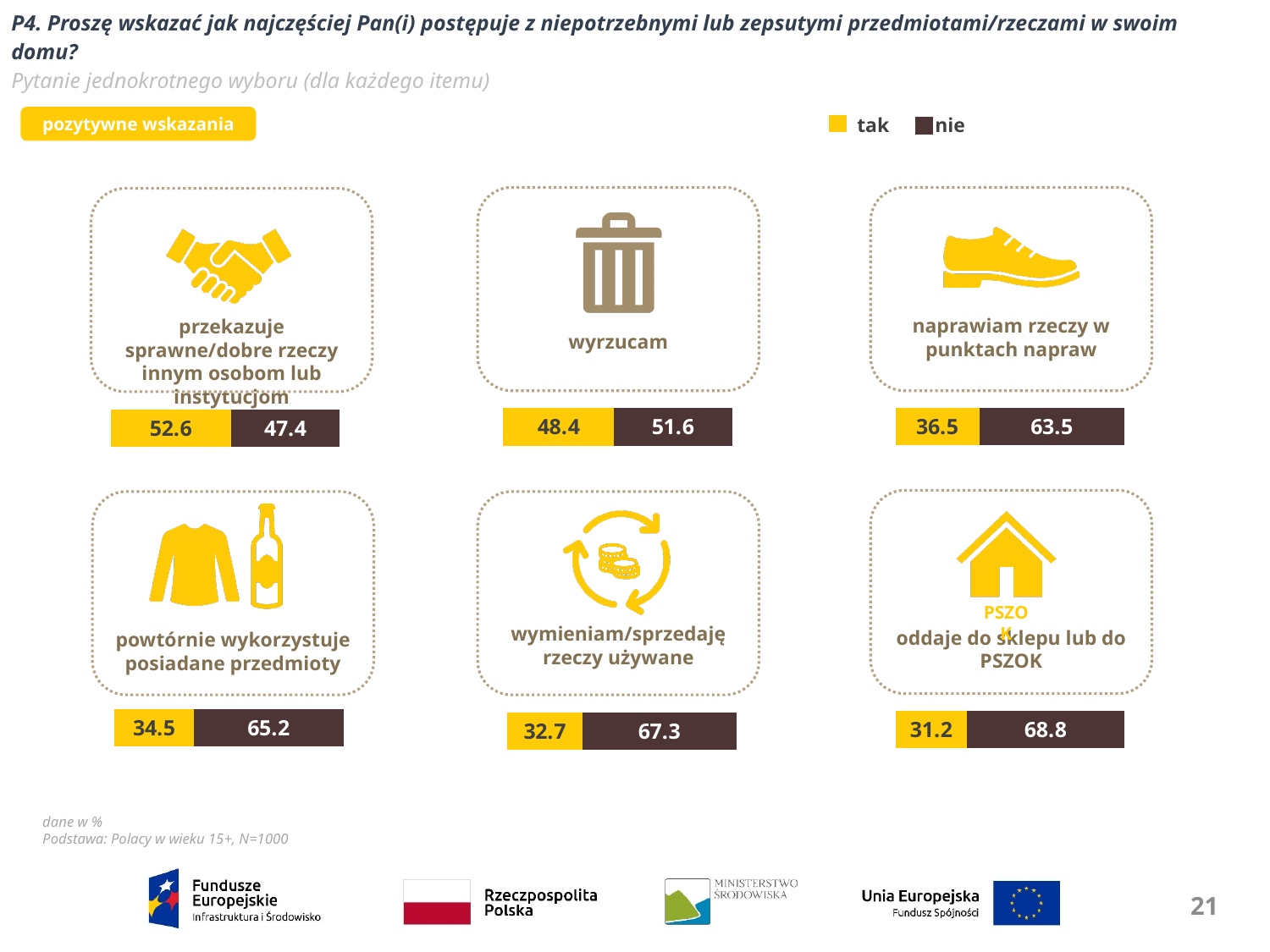
In the bar for "wyrzucam", what is the value for "tak"? 48.4 Which colour represents "tak" in the legend? Yellow In the bar for "oddaje do sklepu lub do PSZOK", what is the value for "tak"? 31.2 What kind of chart is used to show the tak/nie values for each item? Stacked bar chart How many series does the legend list? 2 Which item has the highest "tak" value across the six bars? przekazuje sprawne/dobre rzeczy innym osobom lub instytucjom In the bar for "naprawiam rzeczy w punktach napraw", what is the value for "nie"? 63.5 Is the "tak" value higher for "wyrzucam" or for "naprawiam rzeczy w punktach napraw"? wyrzucam In the bar for "powtórnie wykorzystuje posiadane przedmioty", what is the value for "nie"? 65.2 Which item has the lowest "tak" value across the six bars? oddaje do sklepu lub do PSZOK How many items (bars) are shown on the slide? 6 In the bar for "wymieniam/sprzedaję rzeczy używane", what is the difference between the "nie" and "tak" values? 34.6